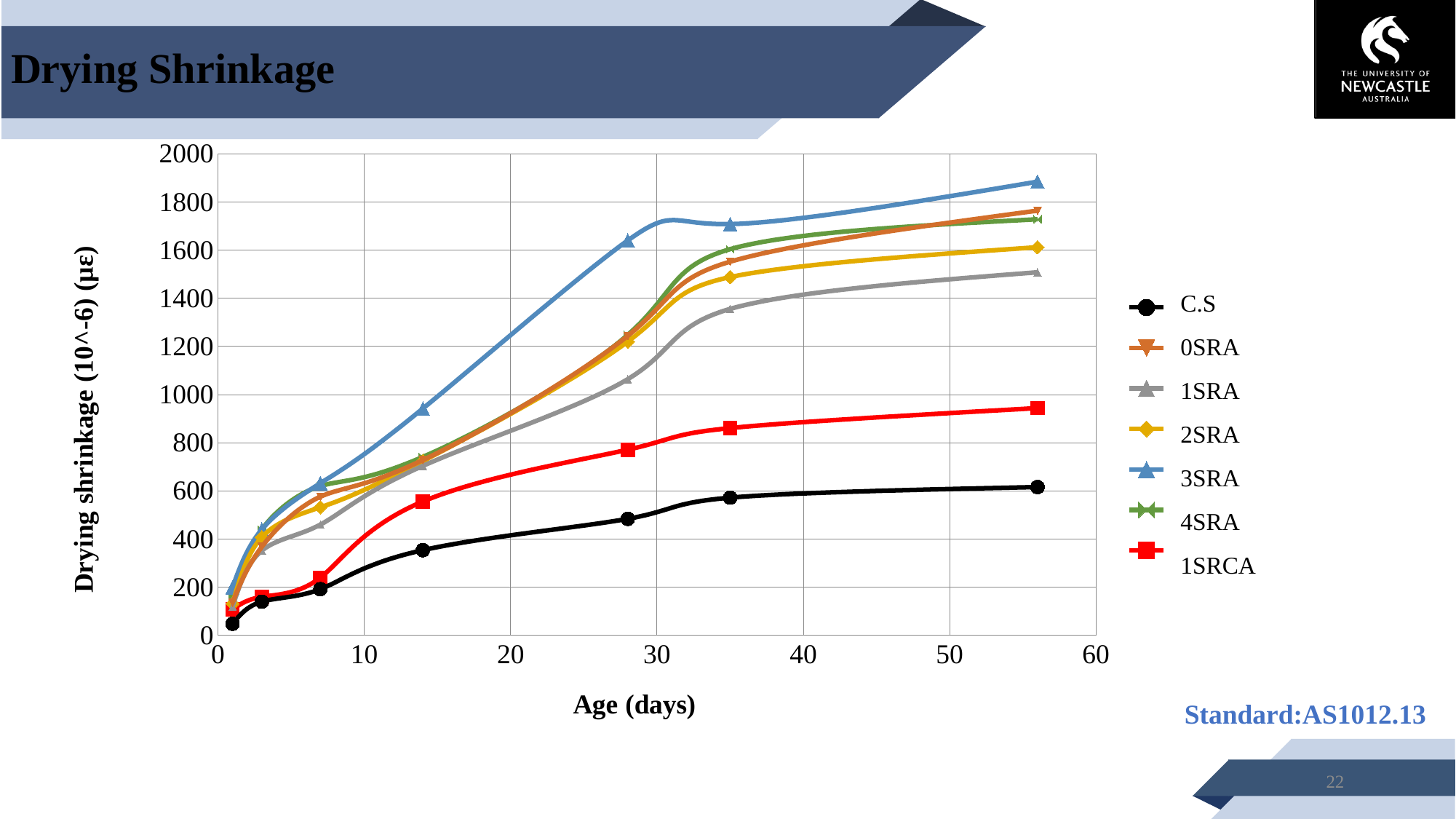
How many series does the legend list? 7 Which is larger at 35 days, the value for 1SRCA or the value for C.S? 1SRCA Which series has the highest drying shrinkage at 56 days? 3SRA Which is larger at 56 days, the value for 2SRA or the value for 1SRA? 2SRA Is the value for C.S at 56 days greater or less than 800? less What is the title of the x axis? Age (days) Which series has the lowest drying shrinkage at 56 days? C.S What kind of chart is shown on the slide? line chart Is the value for 1SRCA at 56 days greater or less than 1000? less Is the value for 3SRA at 56 days greater or less than 1800? greater Does the drying shrinkage for C.S rise or fall as age increases? rise